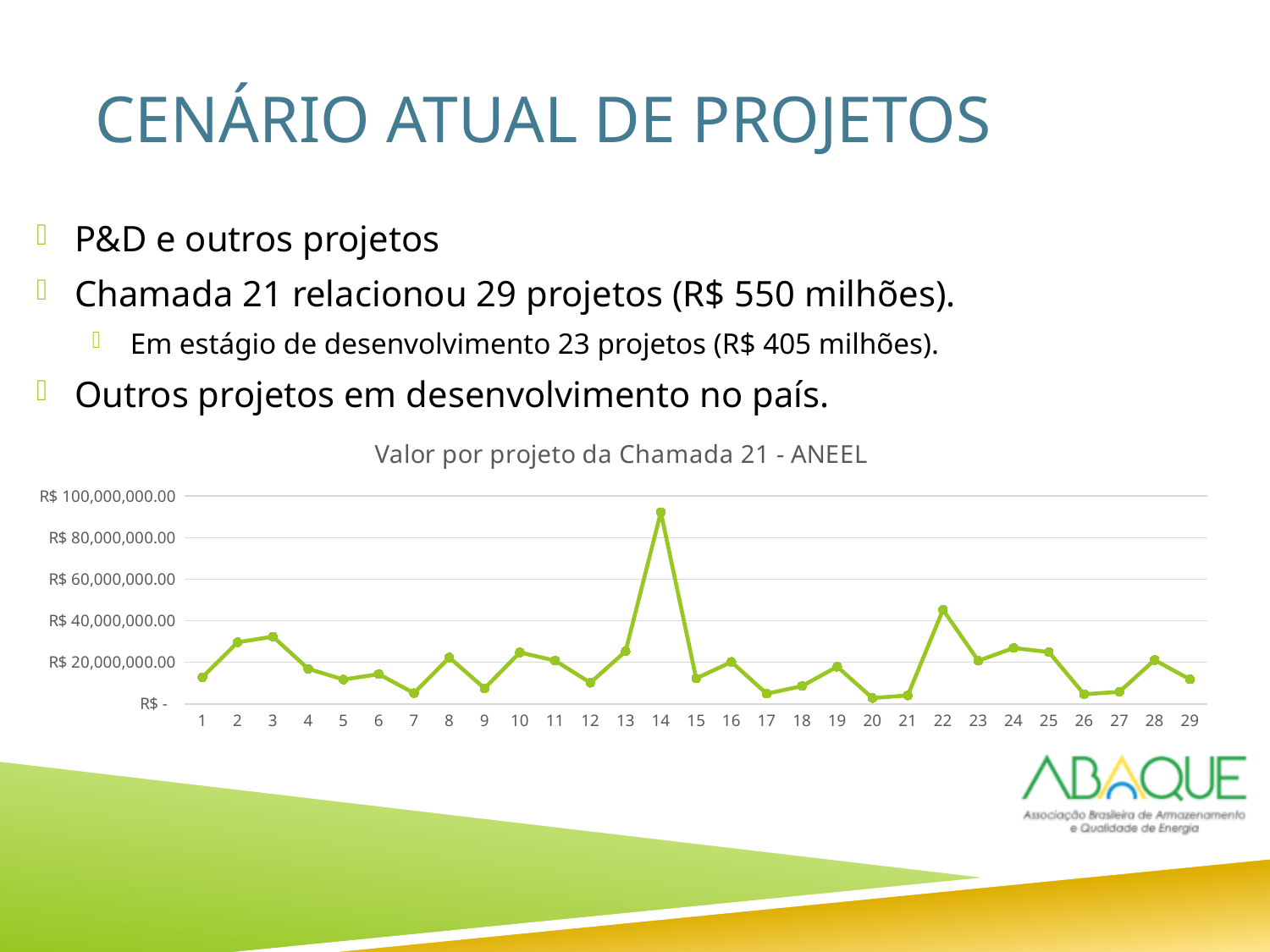
What kind of chart is shown on the slide? line chart What is the highest value shown on the y axis of the chart? R$ 100,000,000.00 Which has a larger value, project 14 or project 22? project 14 Which project has the highest value in the chart? 14 Does the value rise or fall from project 14 to project 15? fall What is the title of the chart? Valor por projeto da Chamada 21 - ANEEL Is the value for project 20 greater or less than R$ 20,000,000.00? less Is the value for project 22 greater or less than R$ 40,000,000.00? greater How many projects are plotted along the x axis of the chart? 29 Is the value for project 3 greater or less than R$ 20,000,000.00? greater Which has a larger value, project 2 or project 7? project 2